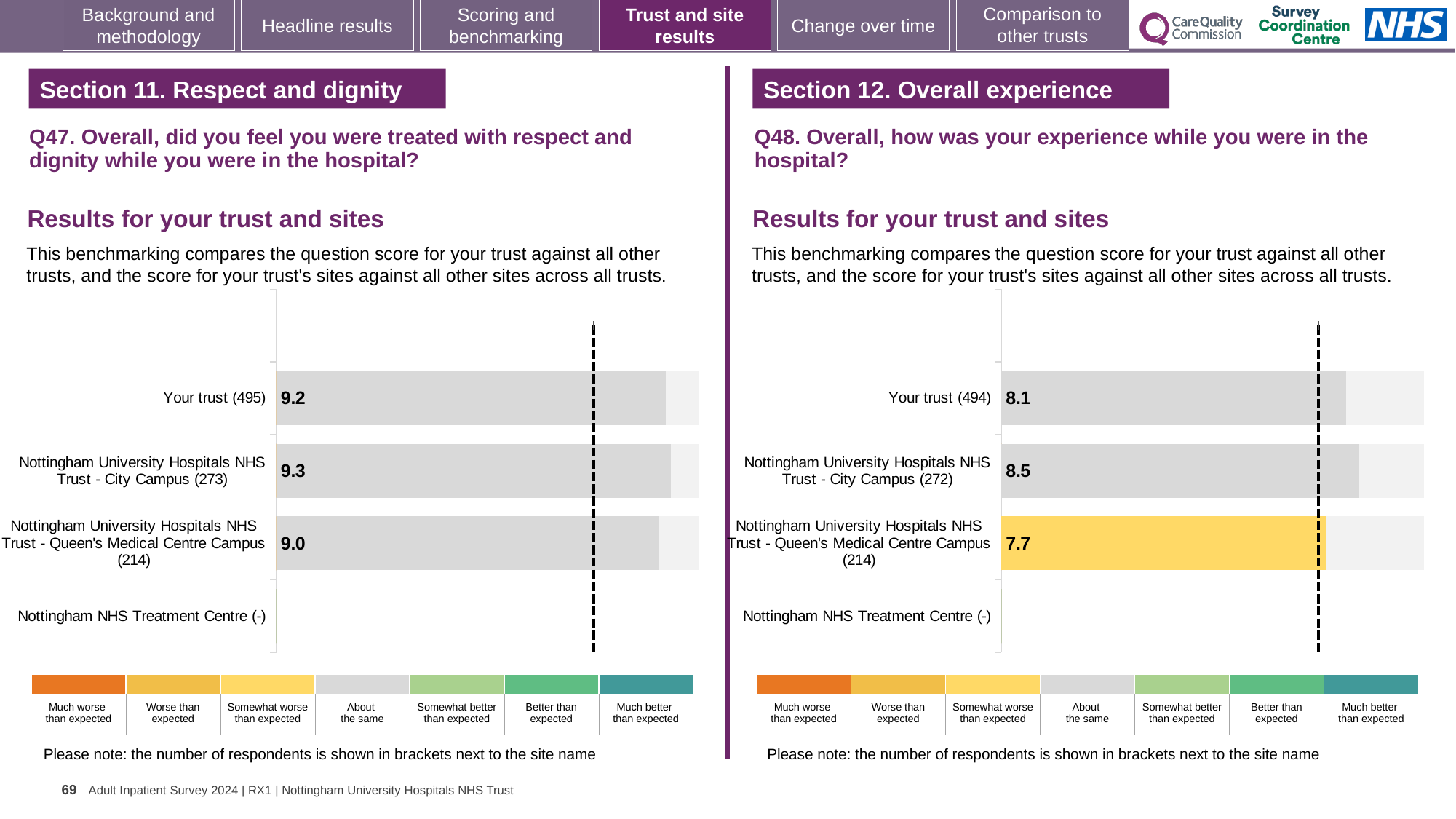
On the Q47 chart (left), what is the score for Nottingham University Hospitals NHS Trust - City Campus (273)? 9.3 What kind of chart is used on the Q47 chart (left)? Bar chart On the Q48 chart (right), which is larger: the score for Your trust (494) or the score for City Campus (272)? City Campus (272) On the Q47 chart (left), which site or trust has the lowest score shown? Nottingham University Hospitals NHS Trust - Queen's Medical Centre Campus (214) On the Q47 chart (left), what is the score for Your trust (495)? 9.2 On the Q48 chart (right), what is the score for Your trust (494)? 8.1 On the Q48 chart (right), which site or trust has the highest score? Nottingham University Hospitals NHS Trust - City Campus (272) On the Q47 chart (left), what is the difference between the City Campus score and the Queen's Medical Centre Campus score? 0.3 On the Q48 chart (right), what is the score for Nottingham University Hospitals NHS Trust - Queen's Medical Centre Campus (214)? 7.7 On the Q48 chart (right), what is the difference between the City Campus score and the Queen's Medical Centre Campus score? 0.8 On the Q48 chart (right), which bar is coloured yellow rather than grey? Nottingham University Hospitals NHS Trust - Queen's Medical Centre Campus (214) On the Q47 chart (left), how many categories are listed on the vertical axis? 4